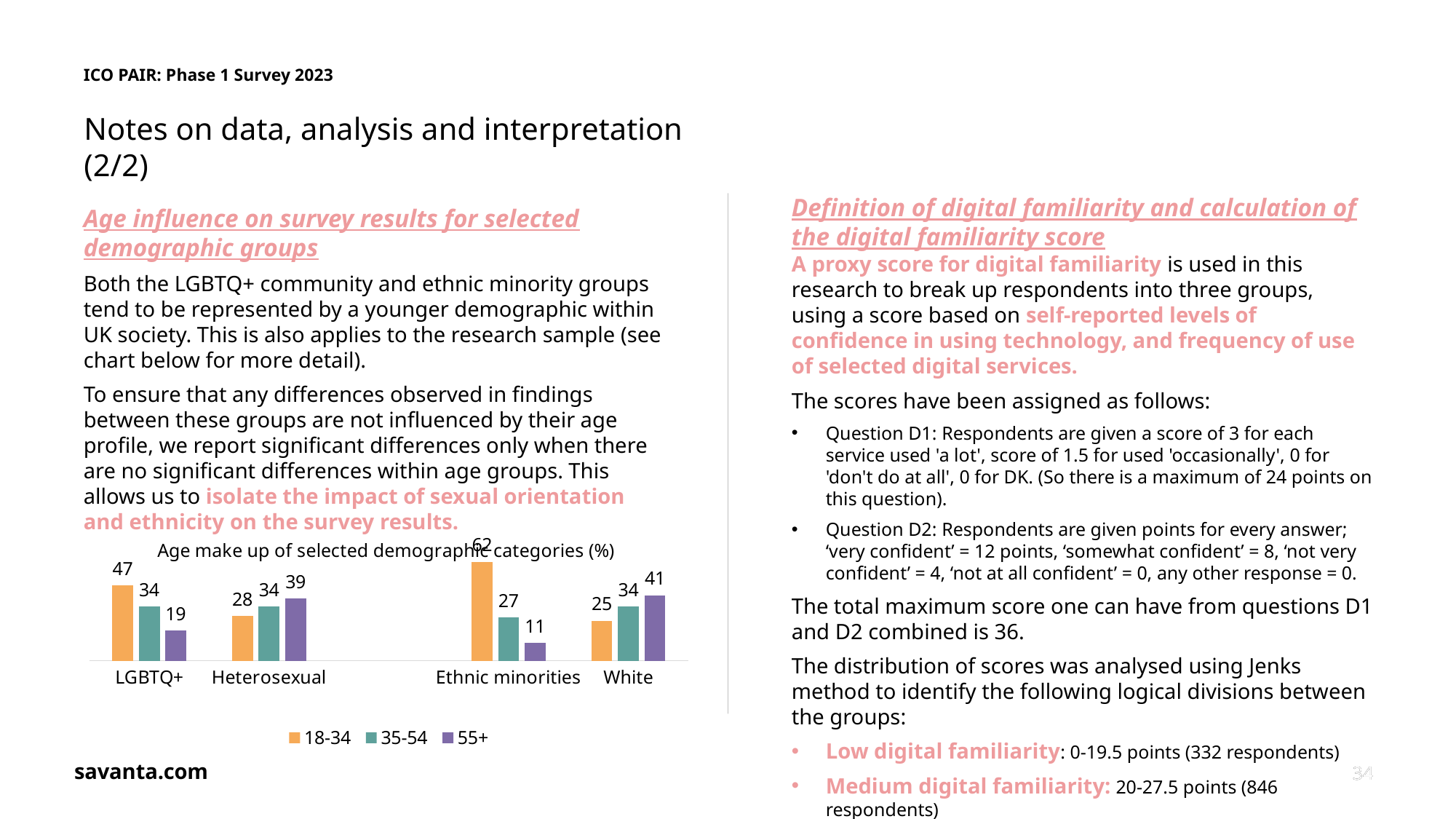
Which category has the highest value for the 18-34 series? Ethnic minorities What is the value for the 35-54 series in the White category? 34 Which is larger: the 18-34 value for LGBTQ+ or the 18-34 value for Heterosexual? LGBTQ+ Which category has the lowest value for the 55+ series? Ethnic minorities How many series does the chart legend list? 3 What is the difference between the 18-34 value and the 55+ value in the Ethnic minorities category? 51 What is the value for the 18-34 series in the LGBTQ+ category? 47 What is the value for the 55+ series in the Ethnic minorities category? 11 What is the title of the chart on the slide? Age make up of selected demographic categories (%) What kind of chart is shown on the slide? Bar chart What is the value for the 55+ series in the Heterosexual category? 39 How many demographic categories are shown on the x axis of the chart? 4